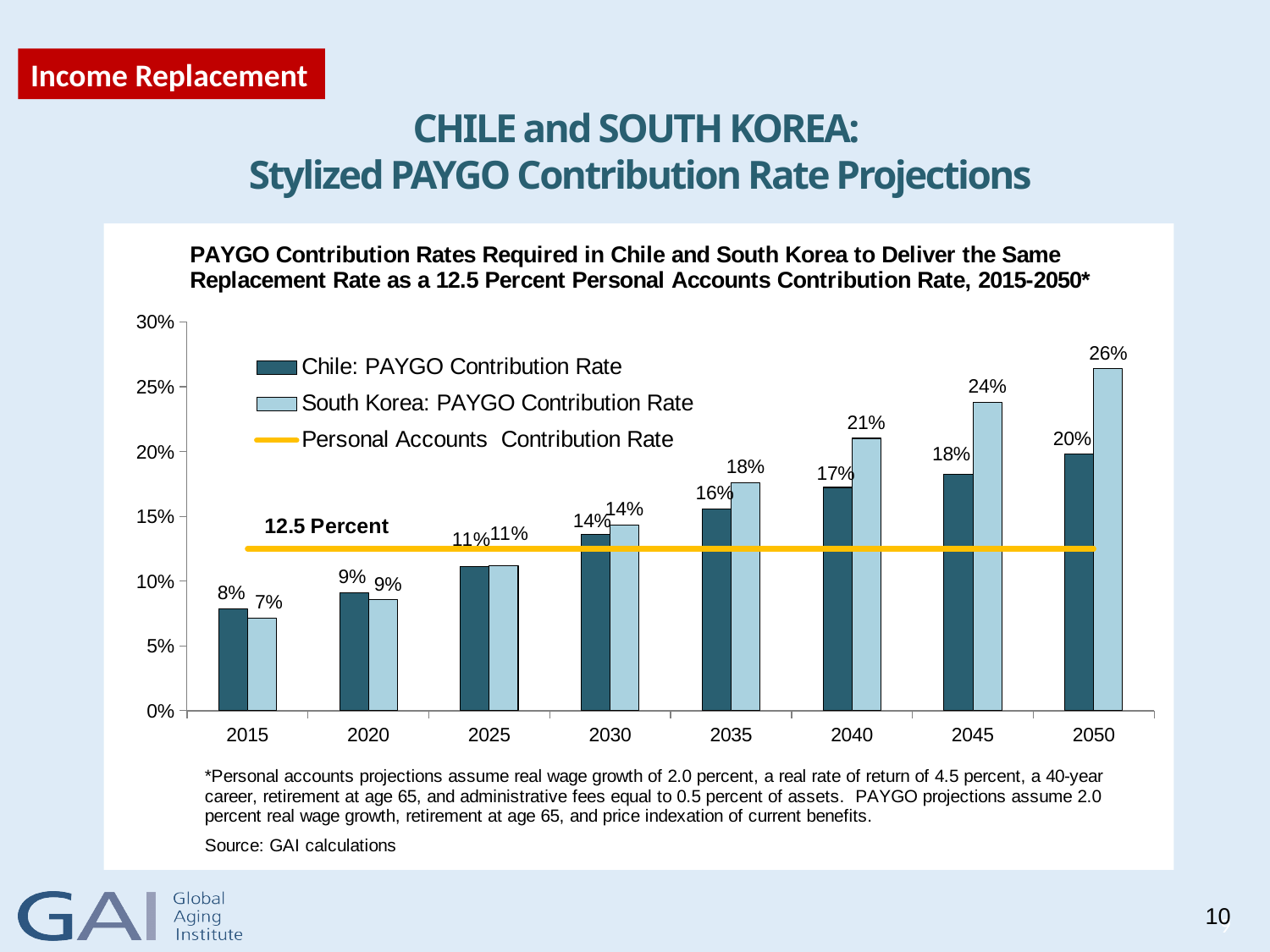
What is South Korea's PAYGO contribution rate in 2045? 24% What is Chile's PAYGO contribution rate in 2035? 16% In 2040, which country has the higher PAYGO contribution rate, Chile or South Korea? South Korea In 2050, how much higher is South Korea's PAYGO contribution rate than Chile's? 6% In which year is South Korea's PAYGO contribution rate highest? 2050 How many years are shown on the x axis? 8 How many entries does the legend list? 3 What kind of chart is used to show the PAYGO contribution rates? Bar chart Do South Korea's PAYGO contribution rates rise or fall from 2015 to 2050? Rise What value does the horizontal yellow line for the Personal Accounts Contribution Rate represent? 12.5 Percent What is Chile's PAYGO contribution rate in 2050? 20% In which year is Chile's PAYGO contribution rate lowest? 2015